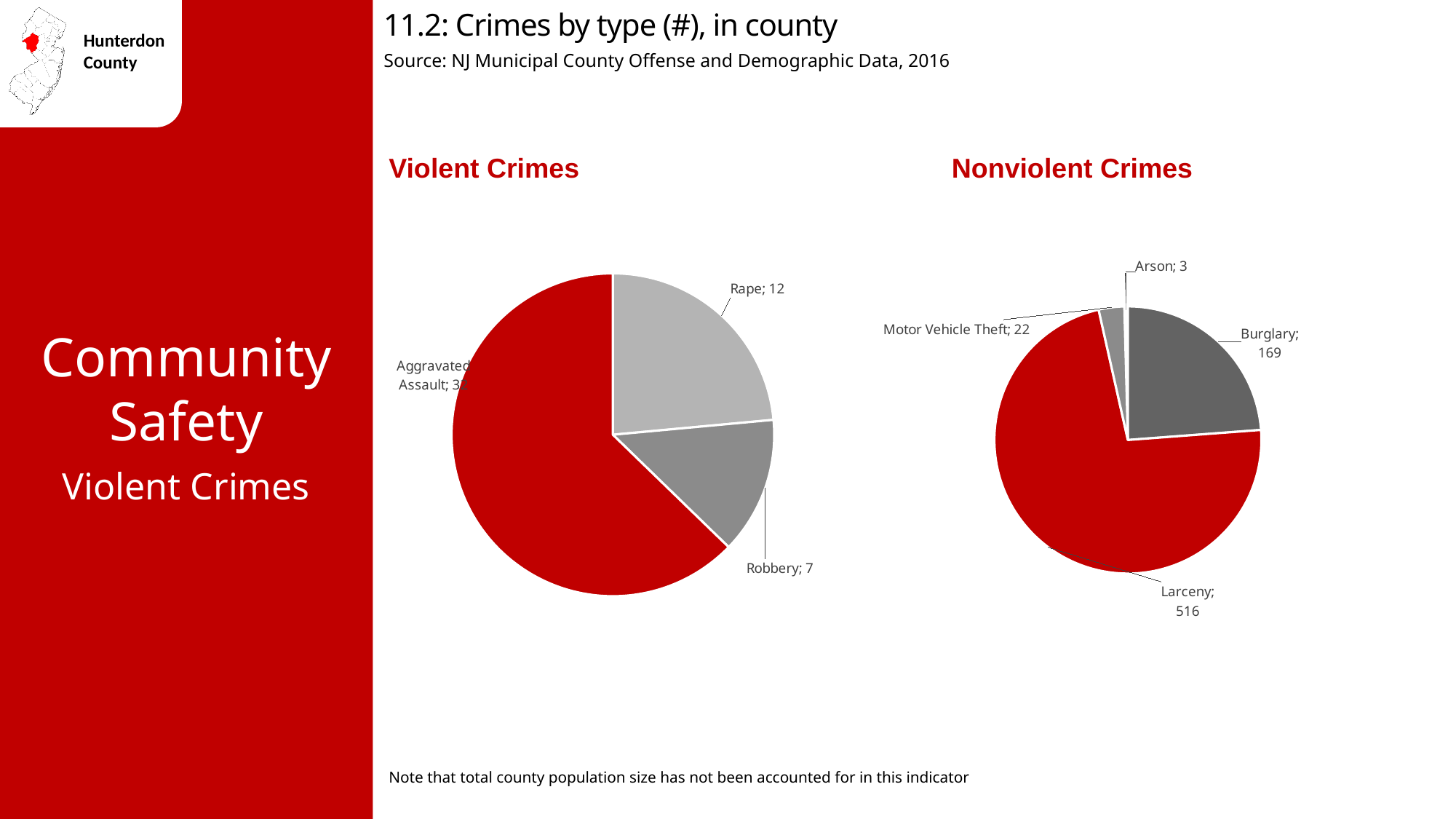
In the Nonviolent Crimes chart, what is the value for Burglary? 169 In the Violent Crimes chart, what is the difference between the Rape and Robbery values? 5 How many crime types are shown in the Nonviolent Crimes chart? 4 In the Violent Crimes chart, what is the value for Robbery? 7 What type of chart is used for Violent Crimes? Pie chart In the Violent Crimes chart, what is the value for Rape? 12 In the Nonviolent Crimes chart, how many larceny crimes are shown? 516 In the Nonviolent Crimes chart, which crime type has the largest slice? Larceny In the Nonviolent Crimes chart, what is the difference between Burglary and Motor Vehicle Theft? 147 In the Nonviolent Crimes chart, which is larger, Motor Vehicle Theft or Arson? Motor Vehicle Theft In the Nonviolent Crimes chart, which crime type has the smallest slice? Arson In the Violent Crimes chart, which crime type has the largest slice? Aggravated Assault